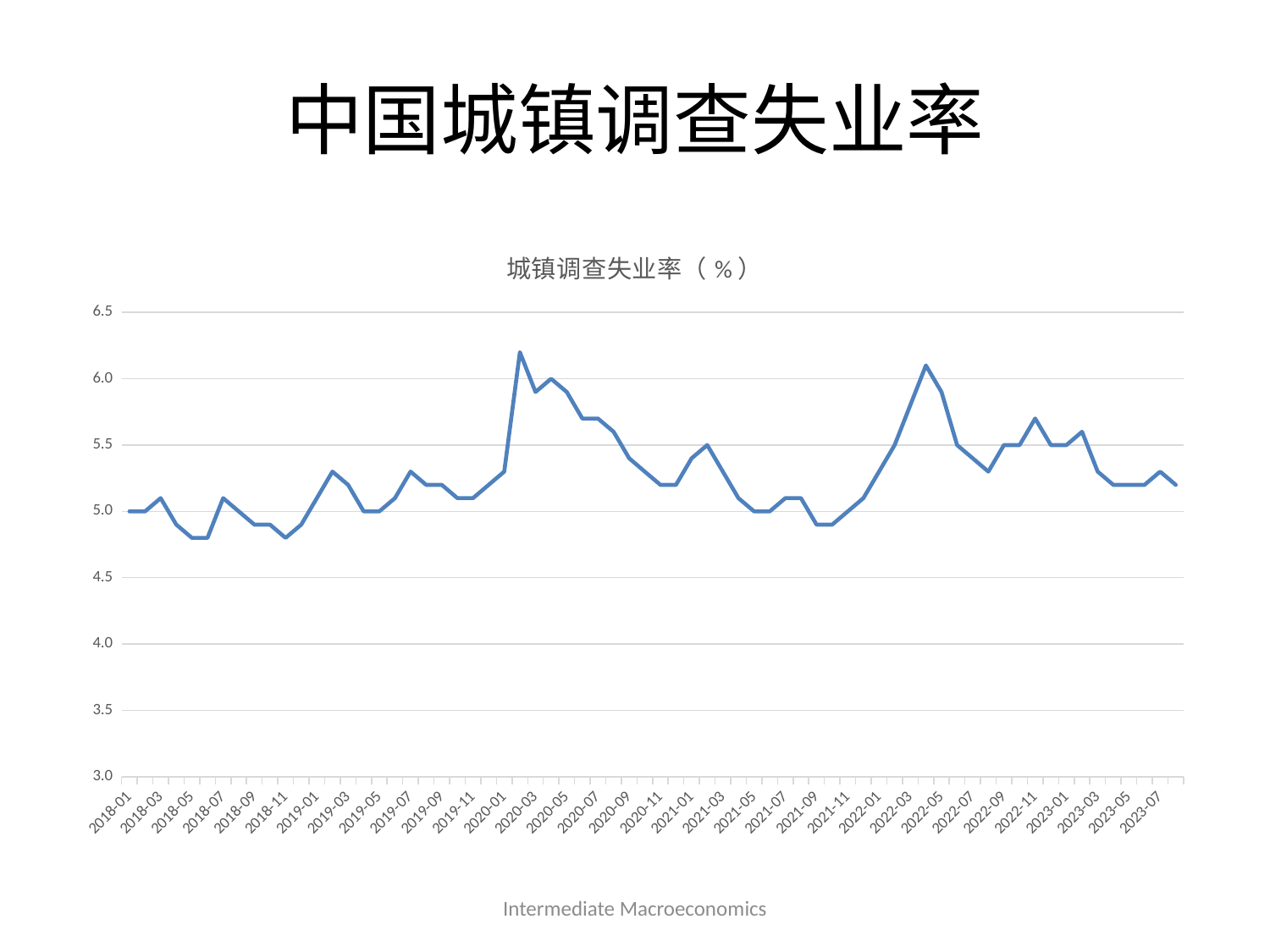
Is the value for 2023-07 greater or less than 5.0? greater What kind of chart is shown on the slide? line chart What is the title printed above the chart? 城镇调查失业率（%） Between 2022-04 and 2022-07, does the line rise or fall? fall Is the value for 2018-06 greater or less than 5.0? less Is the value for 2022-04 greater or less than 5.5? greater What is the value for 2018-01? 5.0 In which month does the line reach its highest point? 2020-02 What is the lowest value shown on the vertical axis? 3.0 Which is larger, the value for 2020-02 or the value for 2018-01? 2020-02